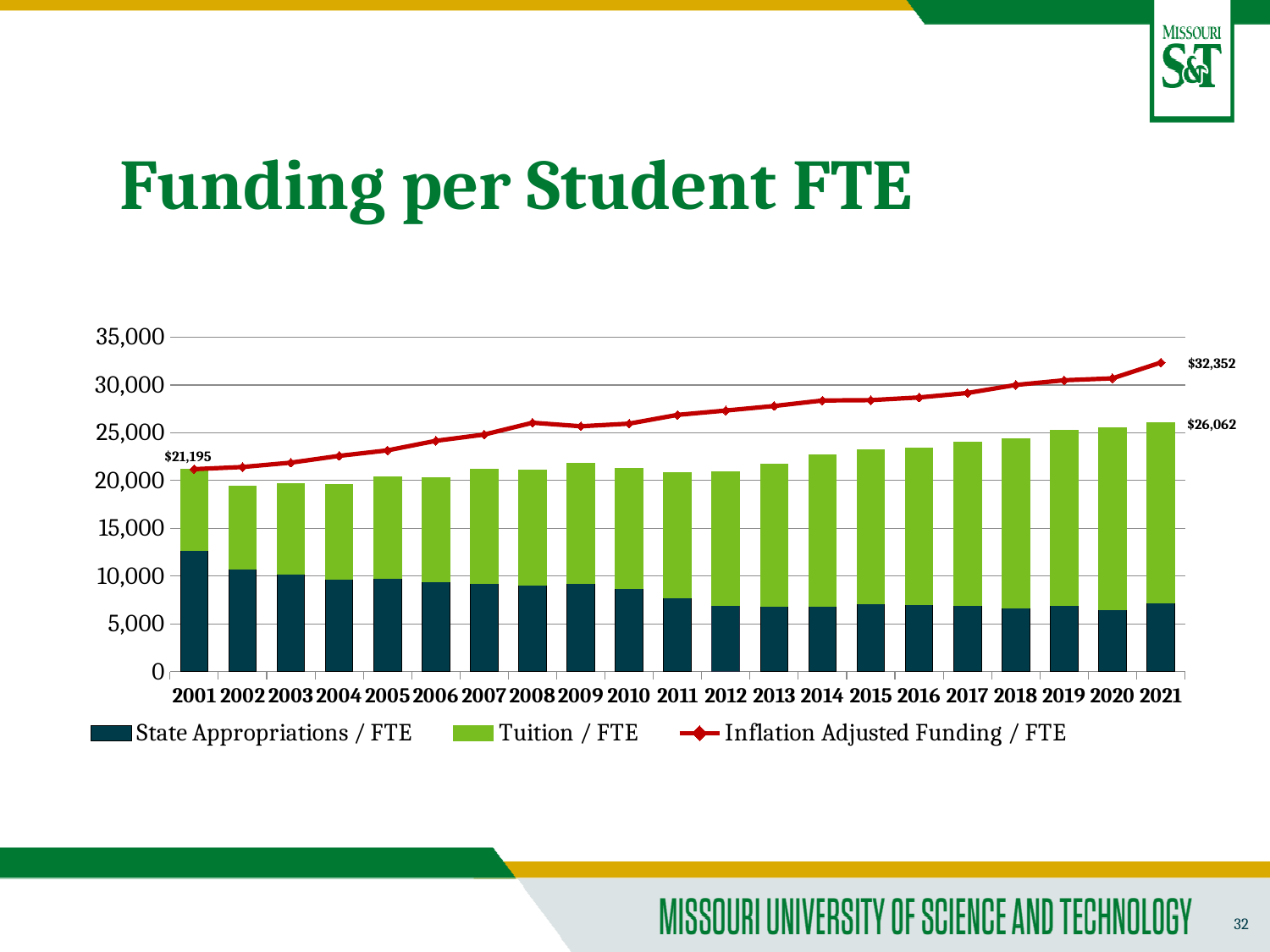
Does the Inflation Adjusted Funding / FTE line rise or fall from 2001 to 2021? Rise What is the Inflation Adjusted Funding / FTE value in 2021? $32,352 What value is labelled at 2001 on the chart? $21,195 Is the State Appropriations / FTE value for 2021 greater or less than 10,000? less What kind of chart is shown on the slide? Bar chart with a line What is the difference between the Inflation Adjusted Funding / FTE in 2021 and the labelled 2001 value? $11,157 How many series does the legend list? 3 Which year has the highest stacked bar total? 2021 How many years are shown along the x axis? 21 In 2021, how much higher is the Inflation Adjusted Funding / FTE than the stacked bar total? $6,290 Is the State Appropriations / FTE value for 2001 greater or less than 10,000? greater What is the total funding per FTE (stacked bar total) in 2021? $26,062